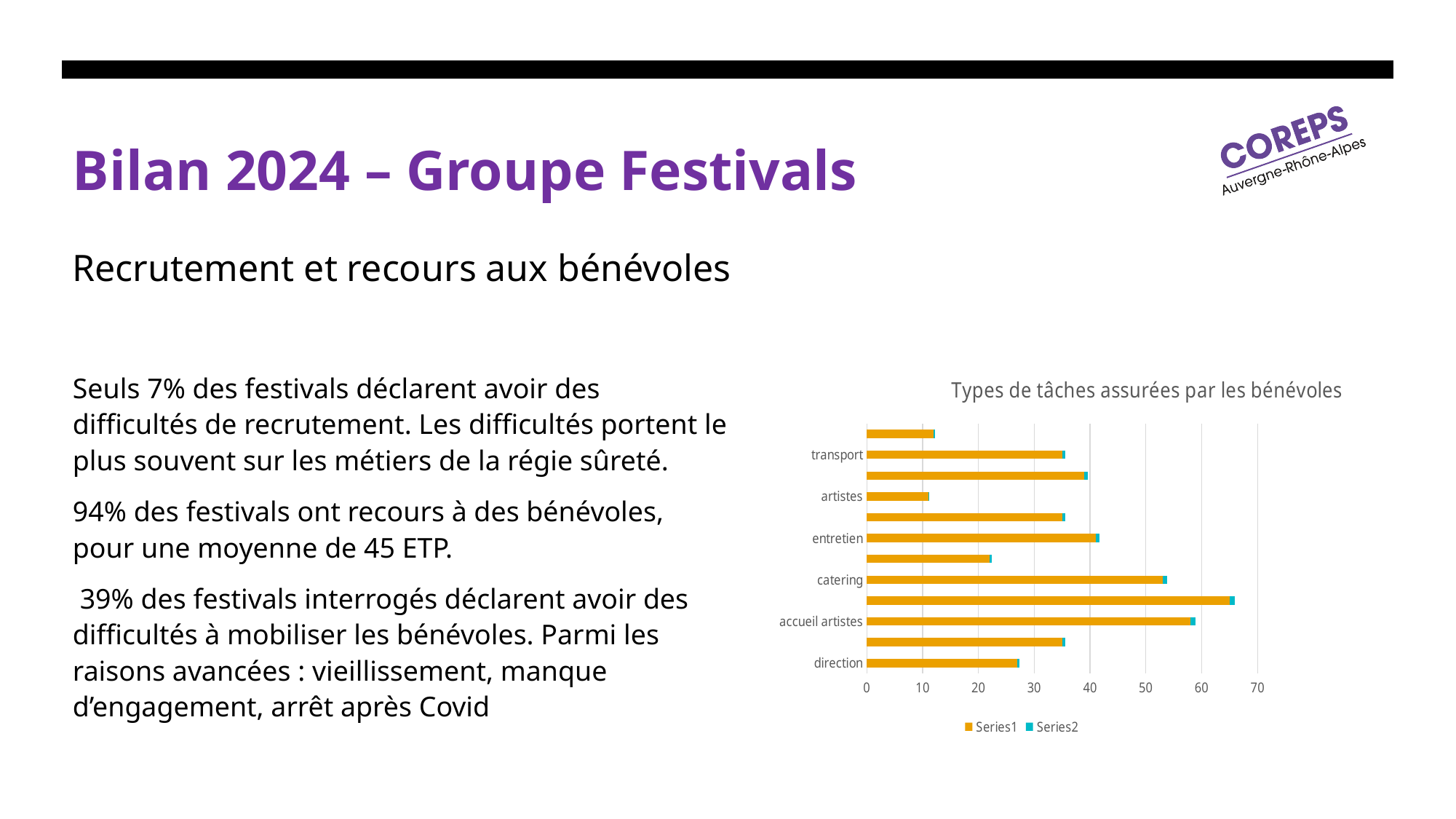
Is the value for catering greater or less than 50? greater Is the value for transport greater or less than 30? greater How many bars are plotted in the chart? 12 Which has the larger value, accueil artistes or direction? accueil artistes What are the names of the series in the chart legend? Series1, Series2 Which has the larger value, catering or artistes? catering How many series does the chart legend list? 2 Is the value for direction greater or less than 30? less What is the title of the chart? Types de tâches assurées par les bénévoles What type of chart is shown on the slide? bar chart